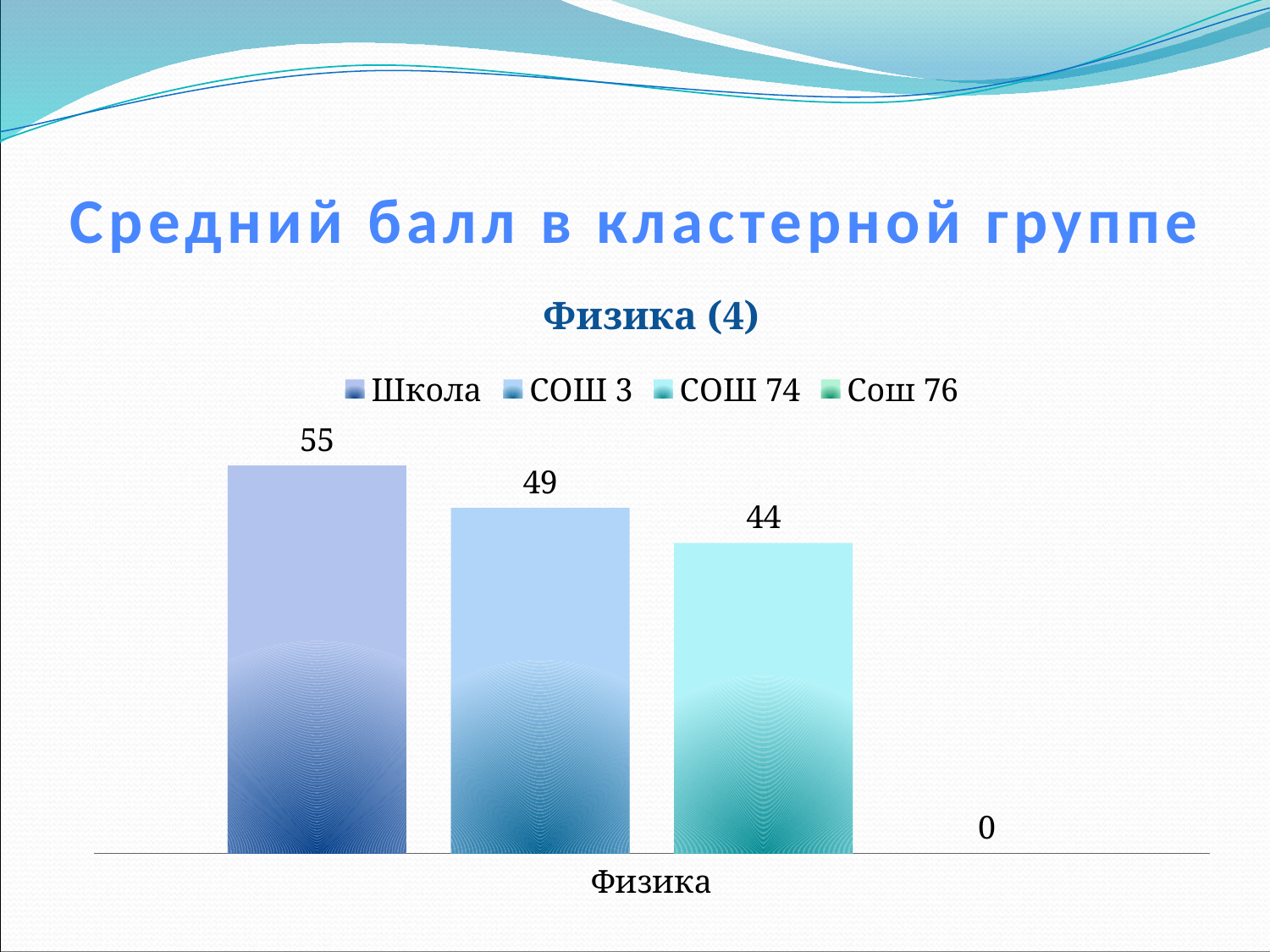
What is the value for СОШ 74 in the Физика (4) chart? 44 What is the title of the chart? Физика (4) Which is larger, the value for СОШ 3 or the value for СОШ 74? СОШ 3 How many series does the legend list? 4 What is the value for СОШ 3 in the Физика (4) chart? 49 What is the difference between the values for СОШ 3 and СОШ 74? 5 Which series has the lowest value in the Физика (4) chart? Сош 76 What is the difference between the values for Школа and СОШ 3? 6 What is the value for Сош 76 in the Физика (4) chart? 0 Which series has the highest value in the Физика (4) chart? Школа What kind of chart is shown on the slide? Bar chart What is the value for Школа in the Физика (4) chart? 55